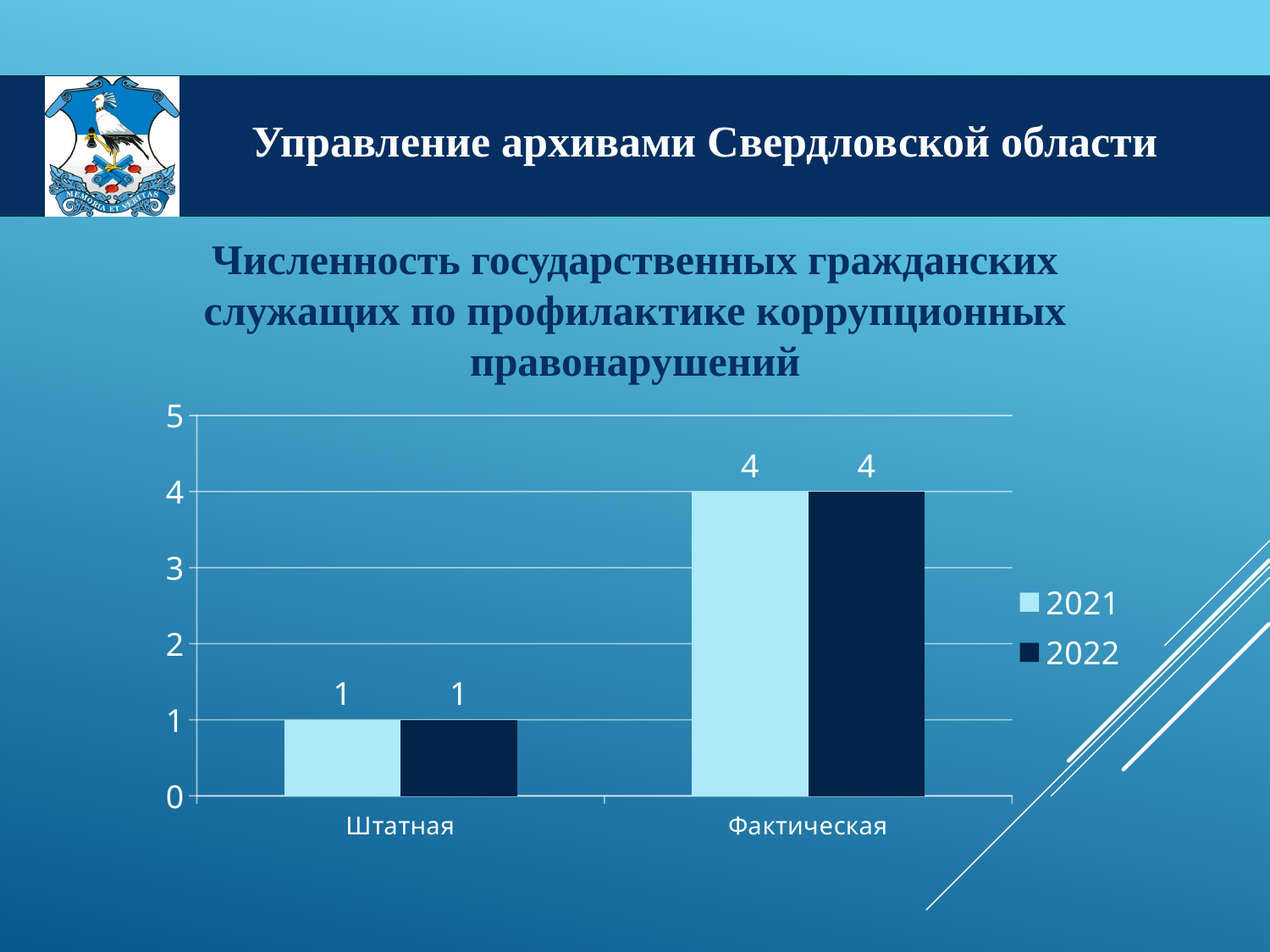
What is the value for Фактическая in 2021? 4 Which category has the highest value in 2022? Фактическая Which is larger: the 2022 value for Штатная or the 2022 value for Фактическая? Фактическая Which category has the lowest value in 2021? Штатная What kind of chart is shown on the slide? bar chart Which series is shown in dark navy in the legend? 2022 What is the difference between the 2021 values for Фактическая and Штатная? 3 How many series does the legend list? 2 Is the value for Фактическая in 2021 greater or less than 3? greater What is the value for Штатная in 2021? 1 What is the value for Фактическая in 2022? 4 How many categories are shown on the x axis? 2